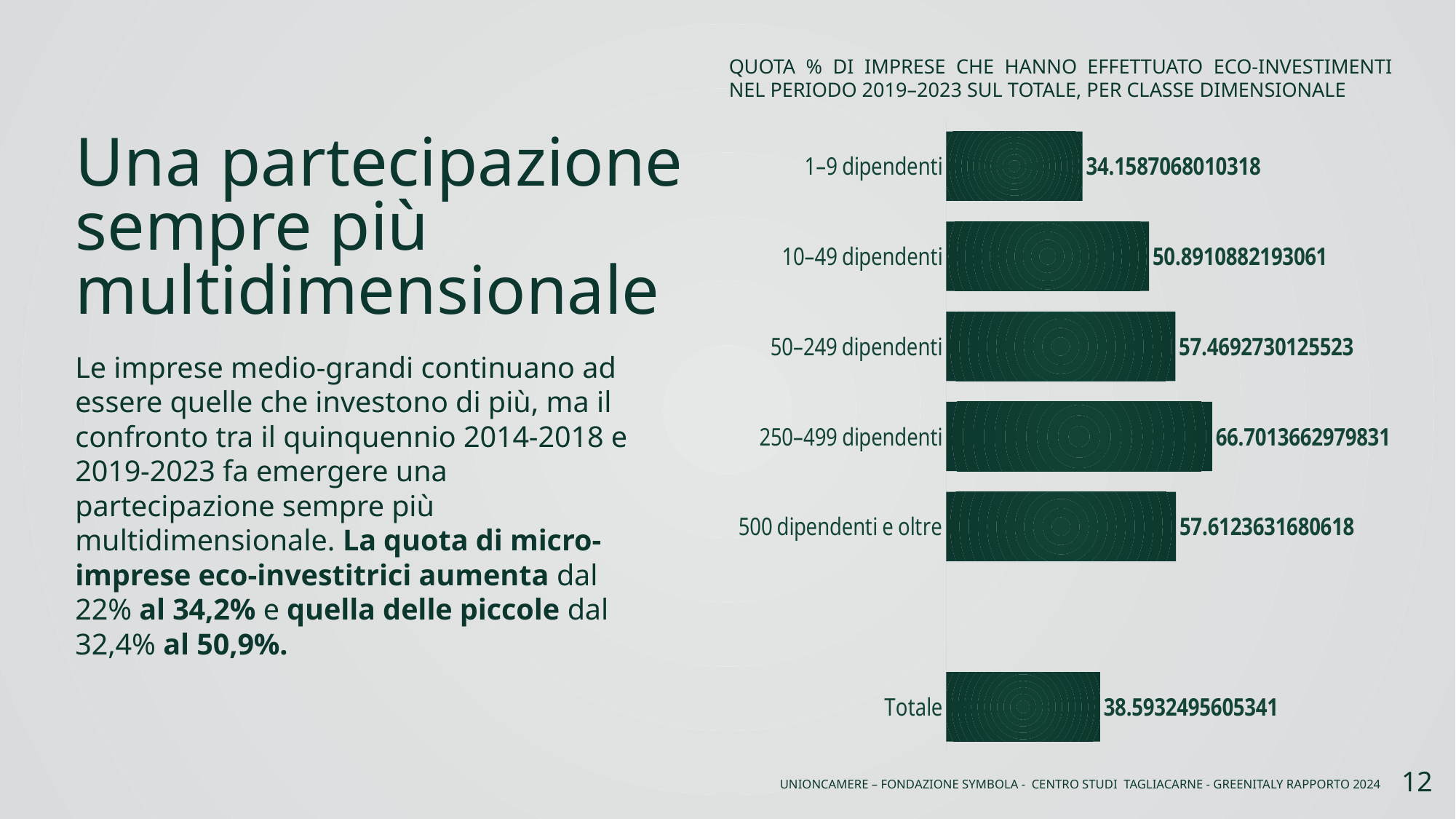
What type of chart is shown on the slide? Bar chart What is the difference between the value for "250–499 dipendenti" and the value for "1–9 dipendenti"? 32.5426594969513 What is the value for "500 dipendenti e oltre"? 57.6123631680618 What is the value for "10–49 dipendenti"? 50.8910882193061 Which is larger, the value for "10–49 dipendenti" or the value for "Totale"? 10–49 dipendenti How many categories (bars) are shown in the chart? 6 Which category has the lowest value? 1–9 dipendenti What is the value for "1–9 dipendenti"? 34.1587068010318 What is the value for "Totale"? 38.5932495605341 What is the value for "50–249 dipendenti"? 57.4692730125523 What is the value for "250–499 dipendenti"? 66.7013662979831 Which category has the highest value? 250–499 dipendenti